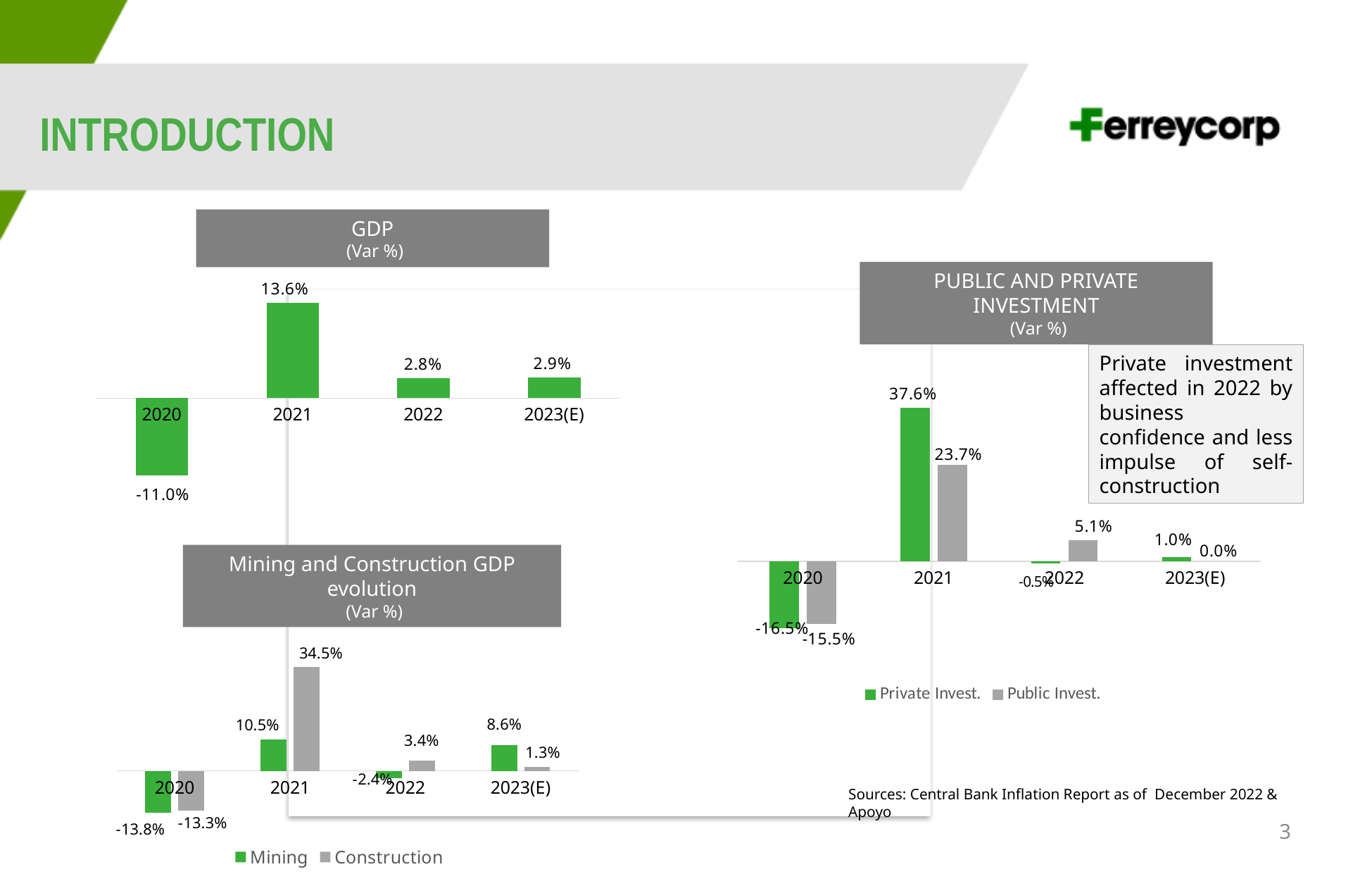
In the Mining and Construction GDP evolution chart, which is larger in 2023(E), Mining or Construction? Mining In the Public and Private Investment chart, what is the difference between Private Invest. and Public Invest. in 2021? 13.9 percentage points In the Public and Private Investment chart, what is the Private Invest. value for 2021? 37.6% What type of chart is the Public and Private Investment chart? Bar chart In the GDP (Var %) chart, what is the value for 2021? 13.6% In the GDP (Var %) chart, how many years are plotted? 4 In the Public and Private Investment chart, what is the Public Invest. value for 2023(E)? 0.0% In the GDP (Var %) chart, which year has the lowest value? 2020 In the Mining and Construction GDP evolution chart, how many series does the legend list? 2 In the GDP (Var %) chart, what is the difference between the 2021 value and the 2022 value? 10.8 percentage points In the Mining and Construction GDP evolution chart, what is the Mining value for 2022? -2.4% In the Mining and Construction GDP evolution chart, what is the Construction value for 2021? 34.5%